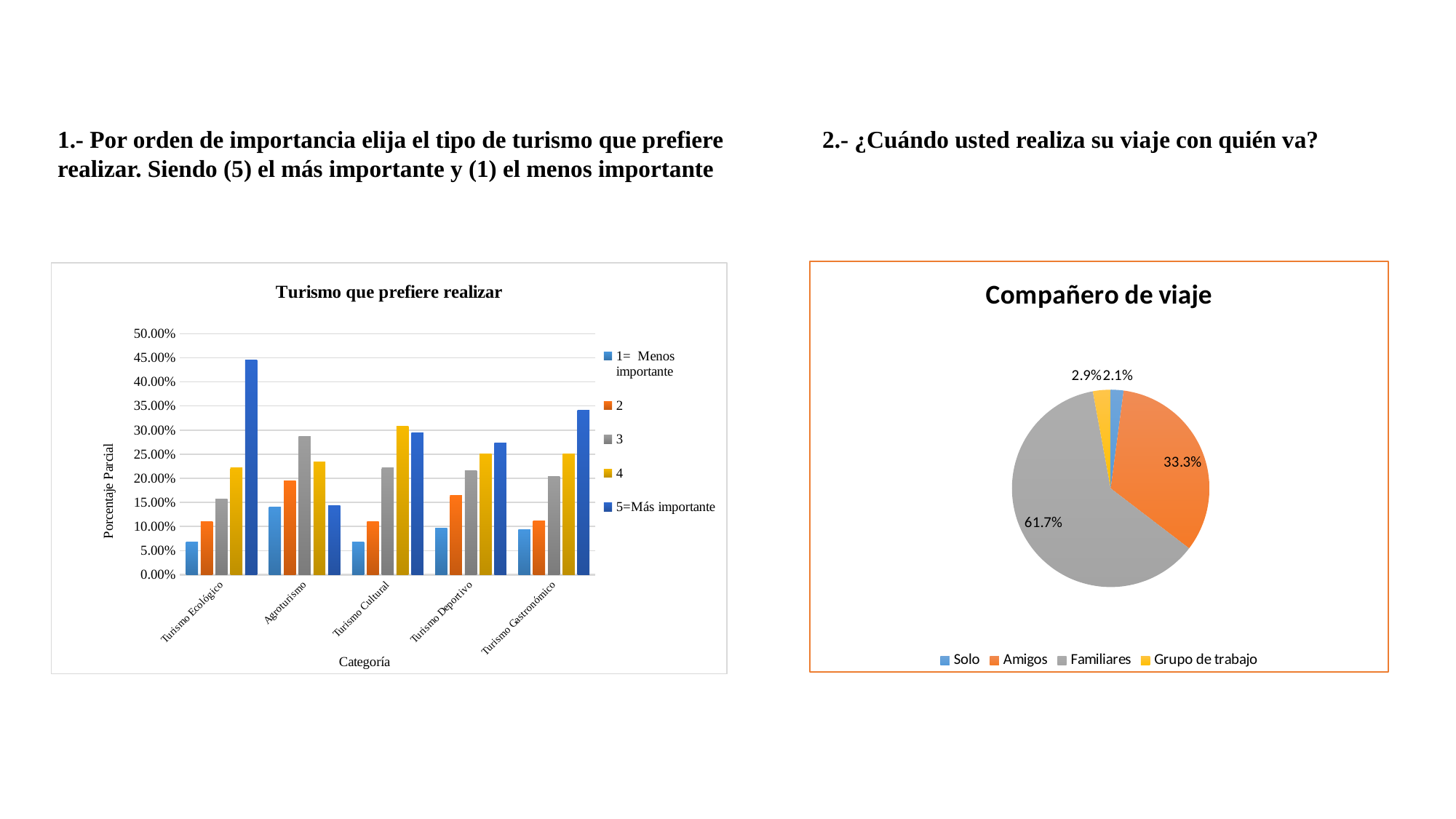
What kind of chart is the 'Turismo que prefiere realizar' chart? bar chart In the 'Turismo que prefiere realizar' chart, which is larger for Turismo Cultural: series '4' or series '2'? 4 What kind of chart is the 'Compañero de viaje' chart? pie chart In the 'Turismo que prefiere realizar' chart, is the value for series '3' in Agroturismo greater or less than 25.00%? greater In the 'Compañero de viaje' chart, what is the difference between Familiares and Amigos? 28.4% In the 'Turismo que prefiere realizar' chart, is the value for '5=Más importante' in Turismo Ecológico greater or less than 40.00%? greater In the 'Compañero de viaje' chart, what share of the pie is Familiares? 61.7% How many categories are shown on the x axis of the 'Turismo que prefiere realizar' chart? 5 How many series does the legend of the 'Turismo que prefiere realizar' chart list? 5 In the 'Turismo que prefiere realizar' chart, which series has the lowest value for Turismo Deportivo? 1= Menos importante In the 'Compañero de viaje' chart, what is the value for Amigos? 33.3% In the 'Turismo que prefiere realizar' chart, which series has the highest value for Turismo Ecológico? 5=Más importante